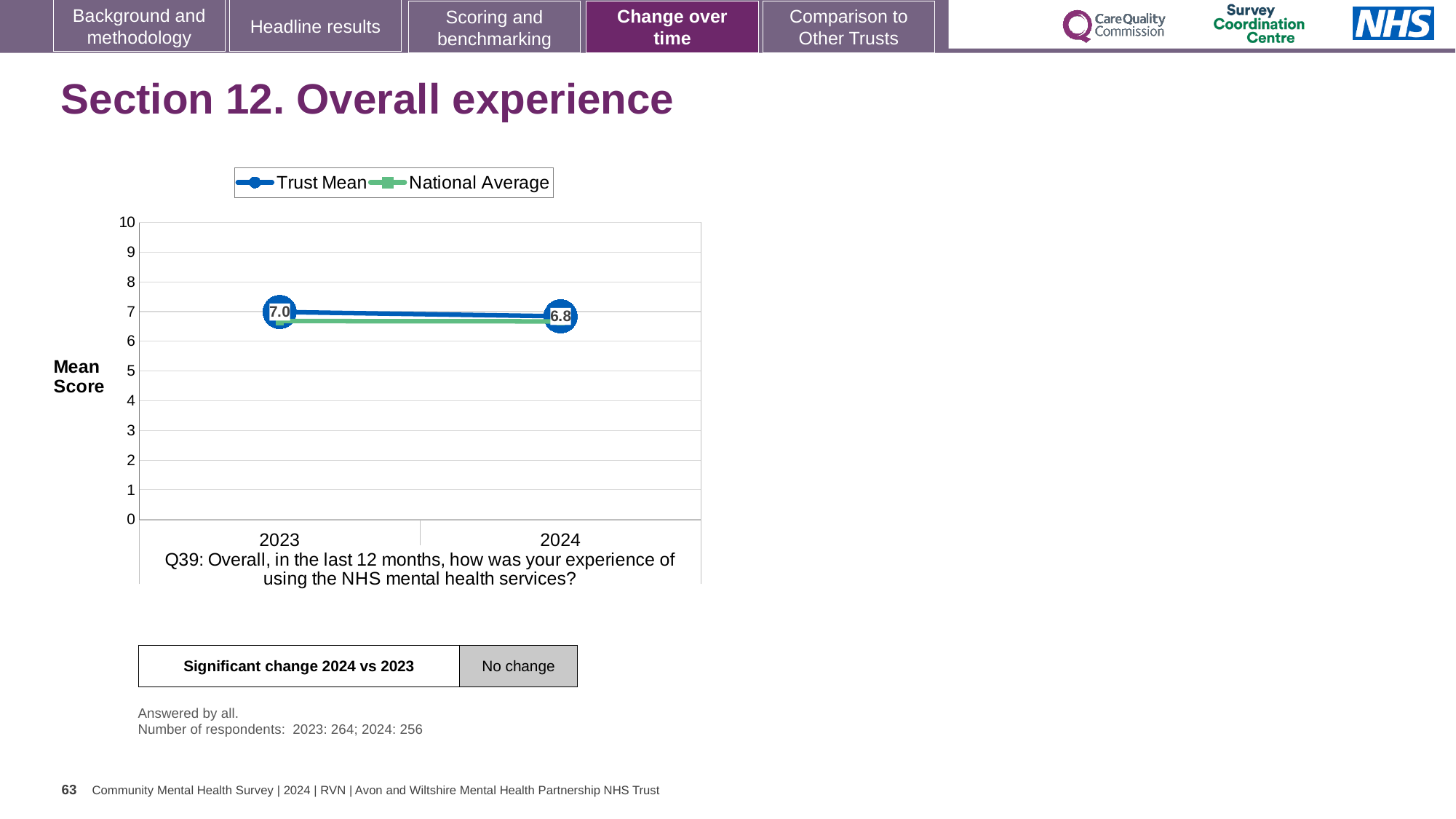
What is the Trust Mean value for 2023? 7.0 By how much did the Trust Mean change from 2023 to 2024? 0.2 How many years are plotted on the x axis? 2 Which year has the higher Trust Mean, 2023 or 2024? 2023 What is the Trust Mean value for 2024? 6.8 Does the Trust Mean rise or fall from 2023 to 2024? fall Is the National Average value for 2023 greater or less than 5? greater What is the label on the y axis of the chart? Mean Score What are the two series named in the legend? Trust Mean and National Average In which year is the Trust Mean lowest? 2024 What kind of chart is shown on the slide? line chart How many series does the legend list? 2